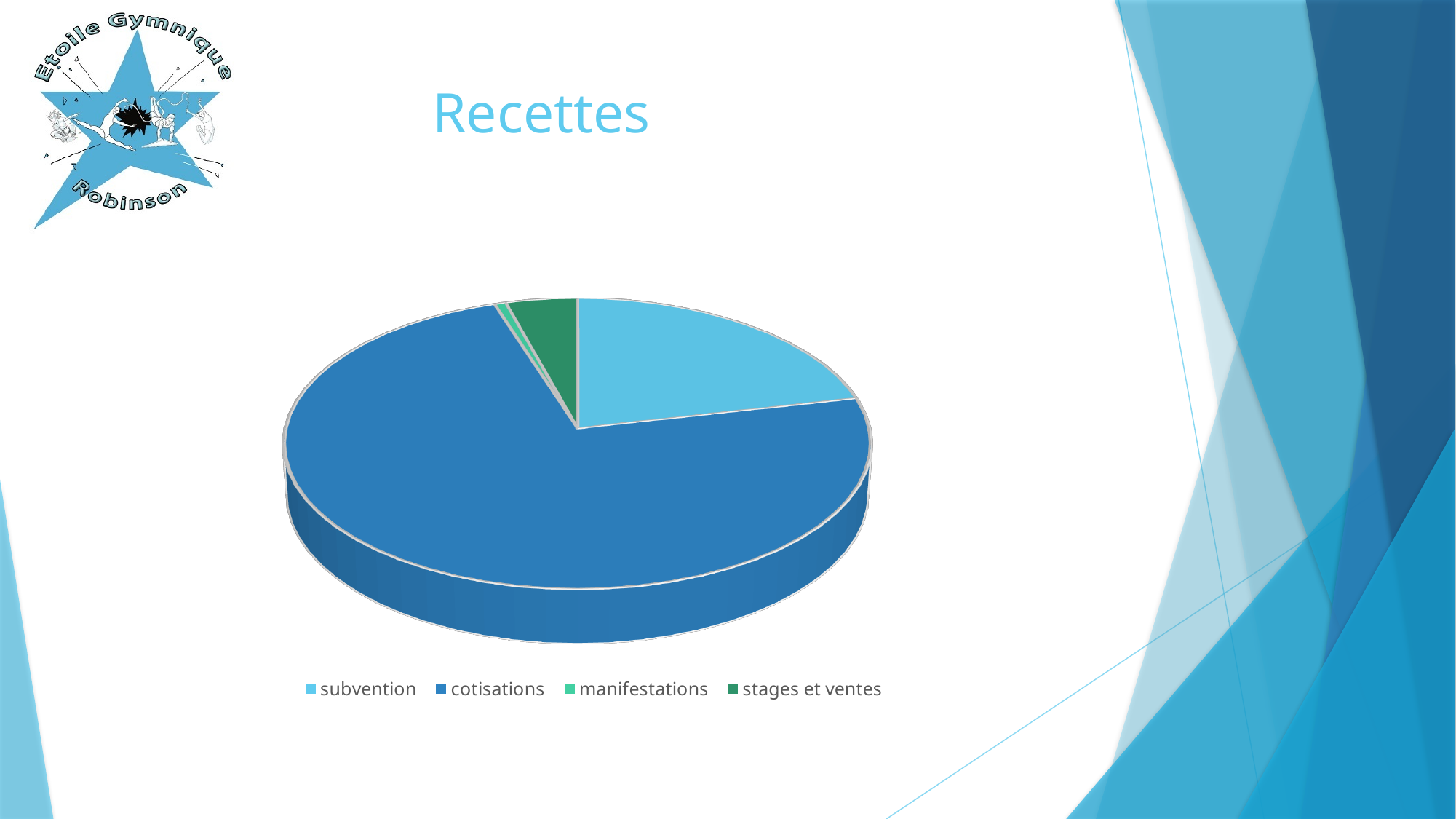
Which category has the second largest slice of the pie? subvention Which category is shown in light blue in the legend? subvention Which category has the smallest slice of the pie? manifestations Which category has the largest slice of the pie? cotisations What is the title of the chart? Recettes Which is larger, the slice for stages et ventes or the slice for manifestations? stages et ventes Which is larger, the slice for subvention or the slice for stages et ventes? subvention How many categories does the pie chart have? 4 Which is larger, the slice for cotisations or the slice for subvention? cotisations What kind of chart is shown on the slide? pie chart